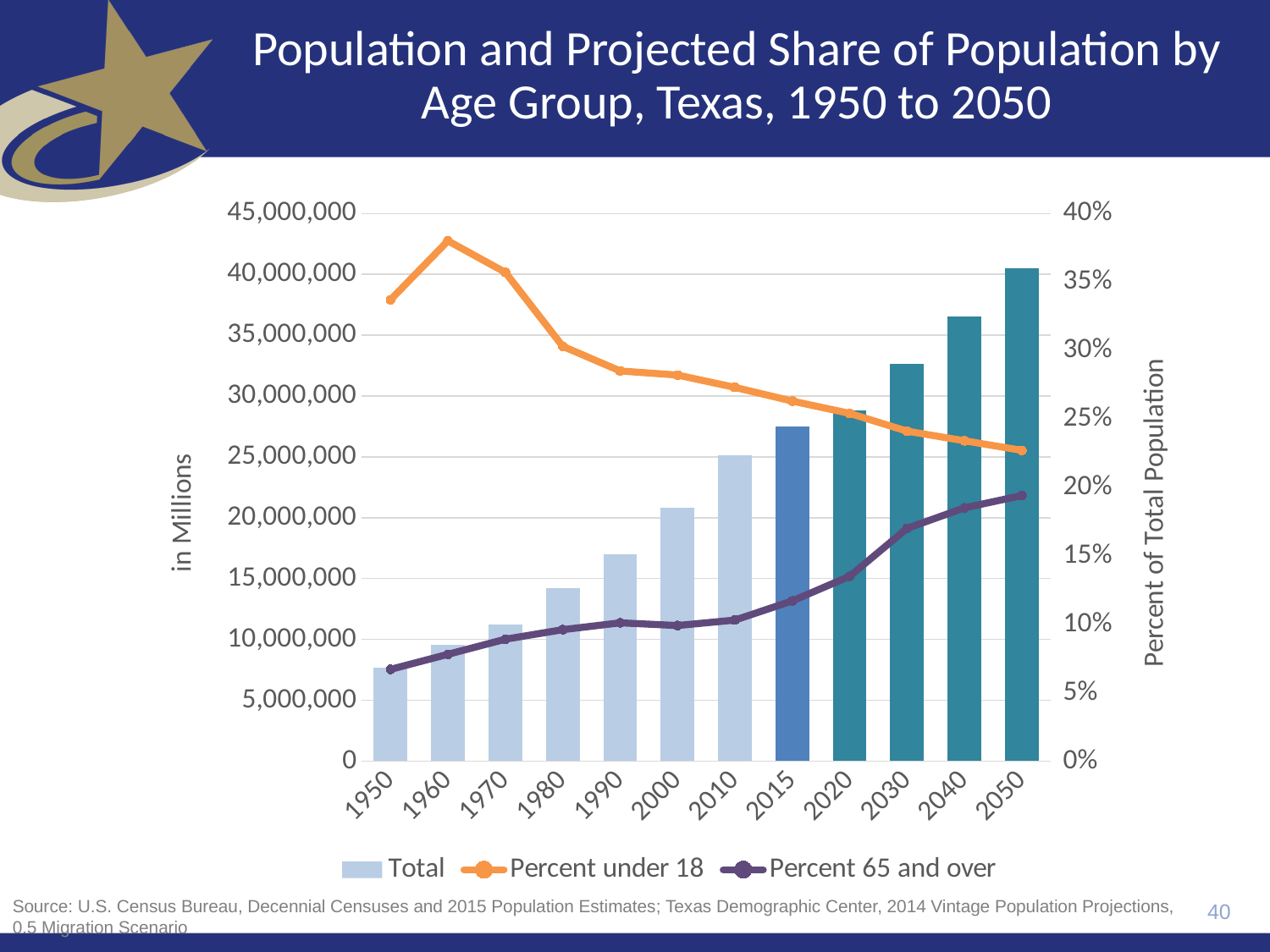
Does the Percent 65 and over line rise or fall from 1950 to 2050? rise What kind of chart is shown on the slide? A combination bar and line chart How many series does the legend list? 3 In which year does the Percent under 18 line reach its highest point? 1960 In which year is the Total population bar the highest? 2050 Is the Total population value for 1950 greater or less than 10,000,000? less How many years are shown along the x axis? 12 Is the Percent 65 and over value for 1950 greater or less than 10%? less Is the Percent under 18 value for 1960 greater or less than 35%? greater In 2050, which is larger: Percent under 18 or Percent 65 and over? Percent under 18 In which year is the Total population bar the lowest? 1950